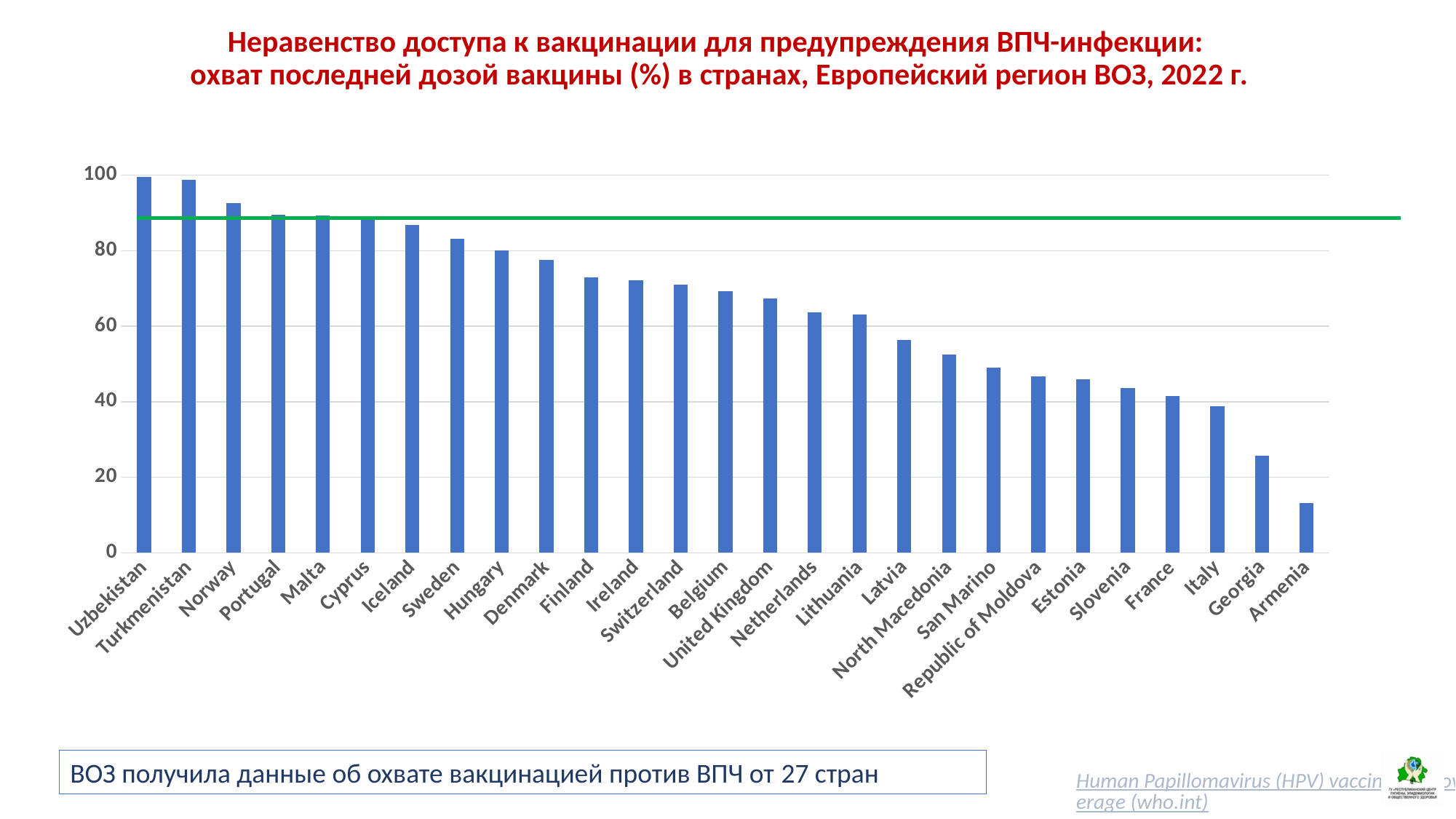
Is the value for Denmark greater or less than 80? less Which has the higher value, Norway or Finland? Norway Which country has the lowest HPV vaccine coverage in the chart? Armenia Is the value for Lithuania greater or less than 60? greater Is the value for Georgia greater or less than 20? greater What colour is the horizontal reference line drawn across the chart? green How many countries are shown on the x axis of the chart? 27 What kind of chart is shown on the slide? bar chart Do the values rise or fall from left to right along the x axis? fall